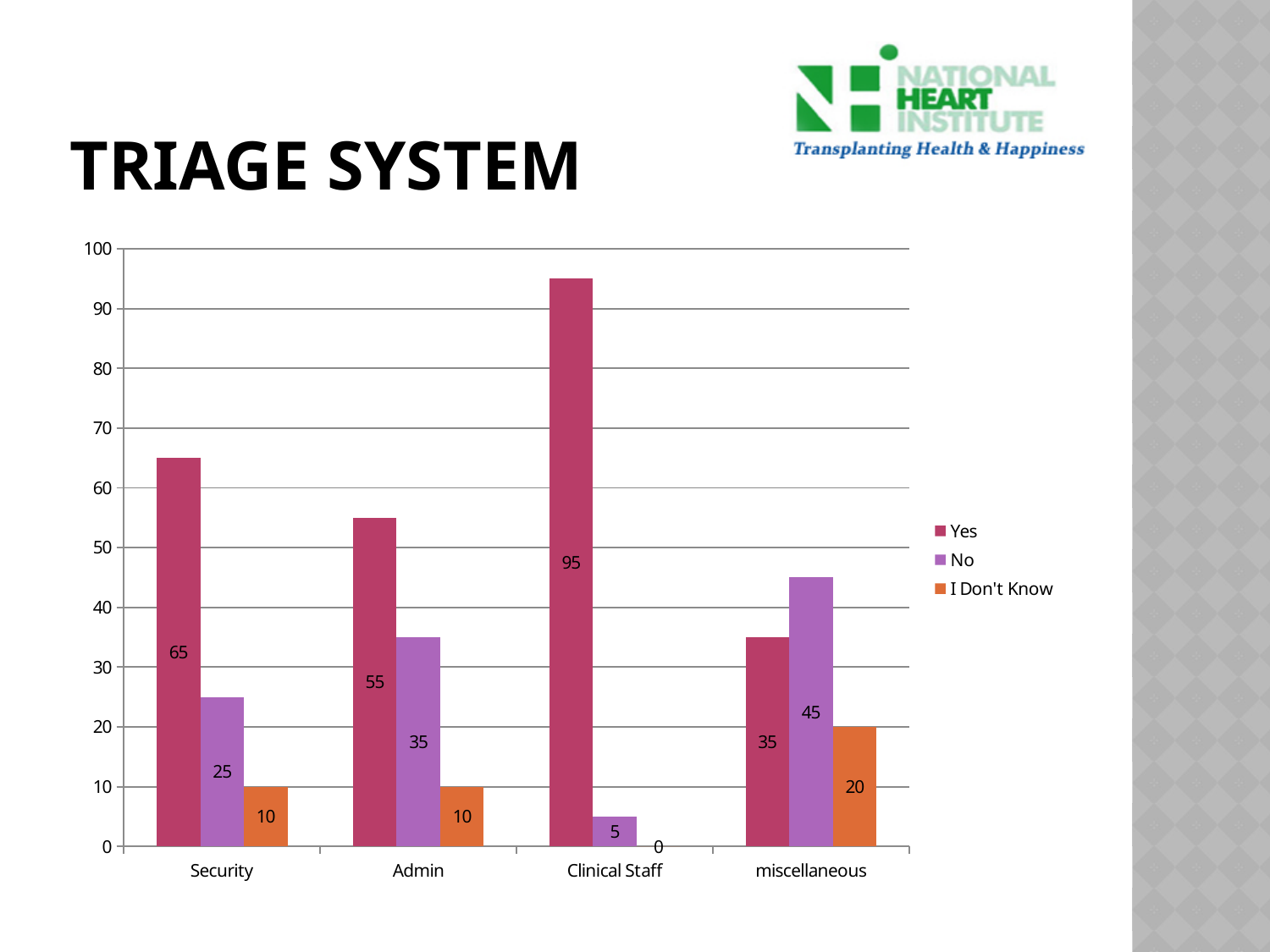
Which is larger for miscellaneous: the 'Yes' value or the 'No' value? No What is the 'No' value for miscellaneous? 45 What is the title of the slide containing the chart? TRIAGE SYSTEM What is the difference between the 'Yes' and 'No' values for Security? 40 What is the 'I Don't Know' value for Admin? 10 How many categories are shown on the x axis? 4 Which category has the lowest 'No' value? Clinical Staff What is the 'Yes' value for Clinical Staff? 95 Is the 'Yes' value for Admin greater or less than 50? greater How many series does the legend list? 3 What kind of chart is shown on the slide? Bar chart Which category has the highest 'Yes' value? Clinical Staff